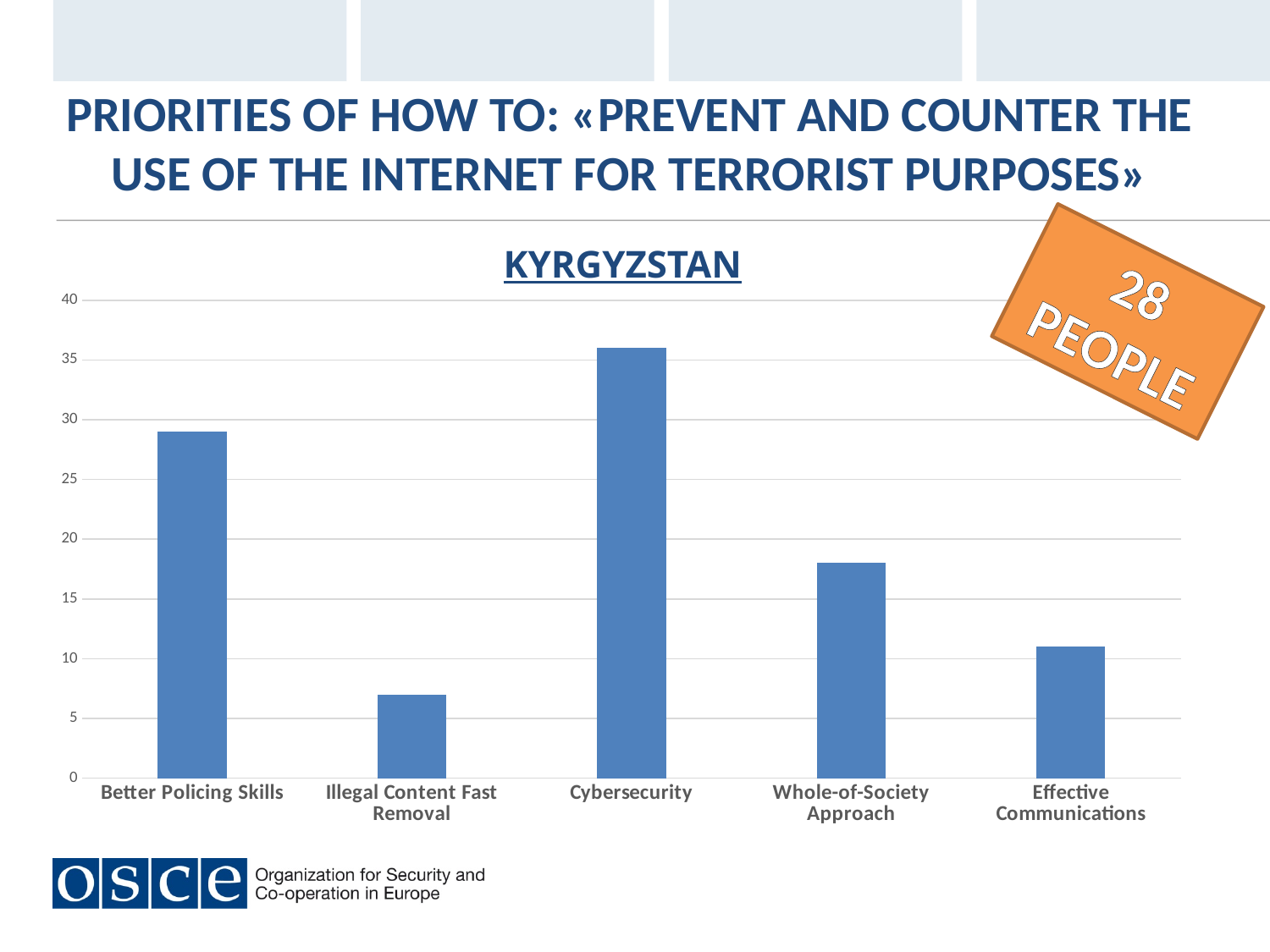
What is the title of the chart? KYRGYZSTAN Is the value for Whole-of-Society Approach greater or less than 20? less Is the value for Effective Communications greater or less than 15? less How many categories are shown on the x axis of the chart? 5 Which category has the lowest bar in the chart? Illegal Content Fast Removal Is the value for Better Policing Skills greater or less than 25? greater Which is larger, the value for Effective Communications or the value for Illegal Content Fast Removal? Effective Communications Which is larger, the value for Better Policing Skills or the value for Whole-of-Society Approach? Better Policing Skills Which category has the highest bar in the chart? Cybersecurity What kind of chart is shown on the slide? bar chart